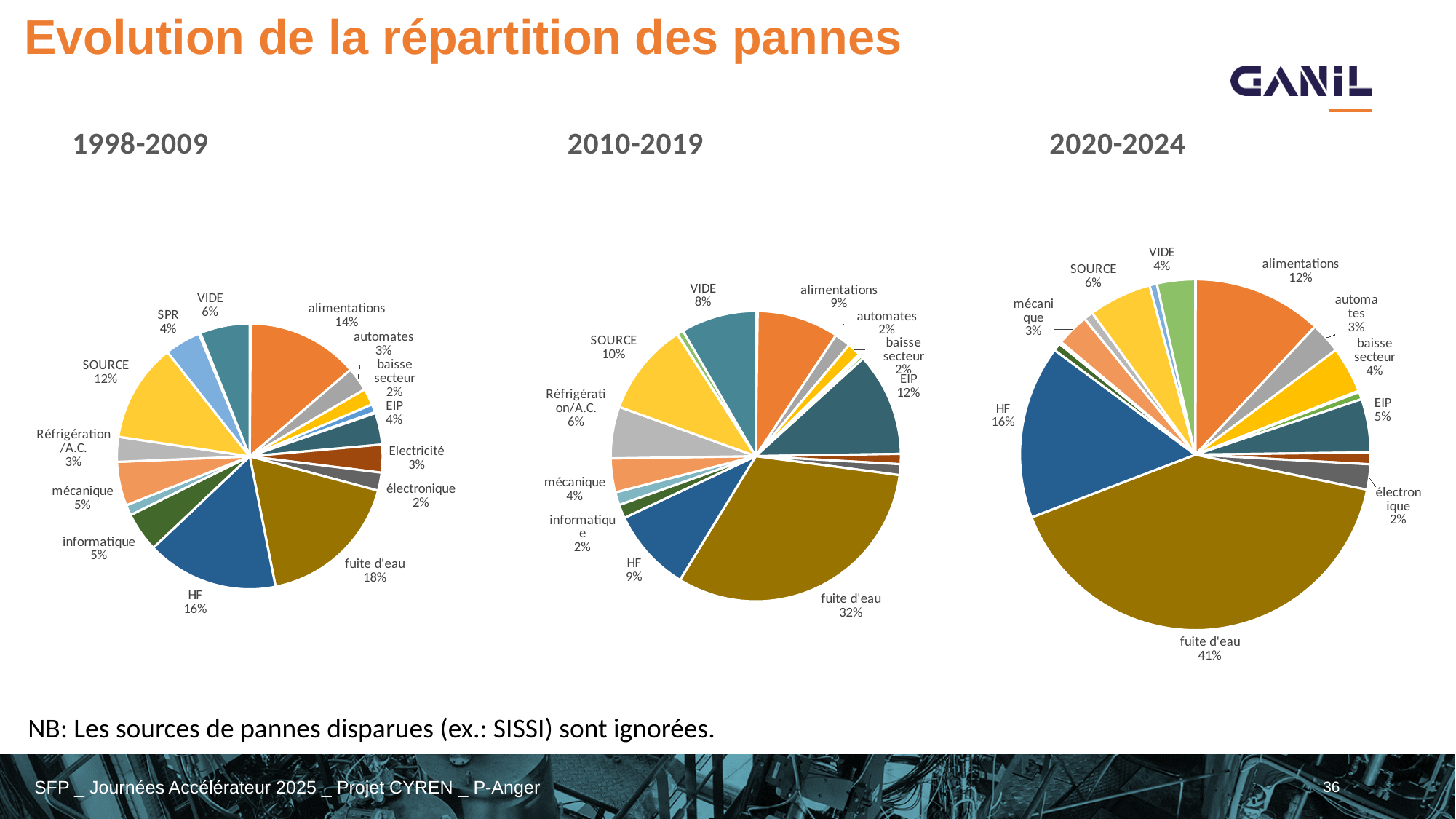
In the 1998-2009 pie chart, which is larger: the share of alimentations or the share of SOURCE? alimentations In the 1998-2009 pie chart, what share of failures is attributed to fuite d'eau? 18% In the 2020-2024 pie chart, what share of failures is attributed to HF? 16% In the 2010-2019 pie chart, what share of failures is attributed to EIP? 12% In the 2010-2019 pie chart, which is larger: the share of SOURCE or the share of VIDE? SOURCE In the 2010-2019 pie chart, which category has the largest share? fuite d'eau How many pie charts are shown on the slide? 3 In the 2020-2024 pie chart, which category has the largest share? fuite d'eau What kind of charts are shown on the slide? Pie charts How does the share of fuite d'eau change across the three pie charts from 1998-2009 to 2020-2024? It rises (18%, 32%, 41%) In the 2020-2024 pie chart, what is the difference between the shares of fuite d'eau and alimentations? 29% In the 1998-2009 pie chart, what is the difference between the shares of fuite d'eau and HF? 2%